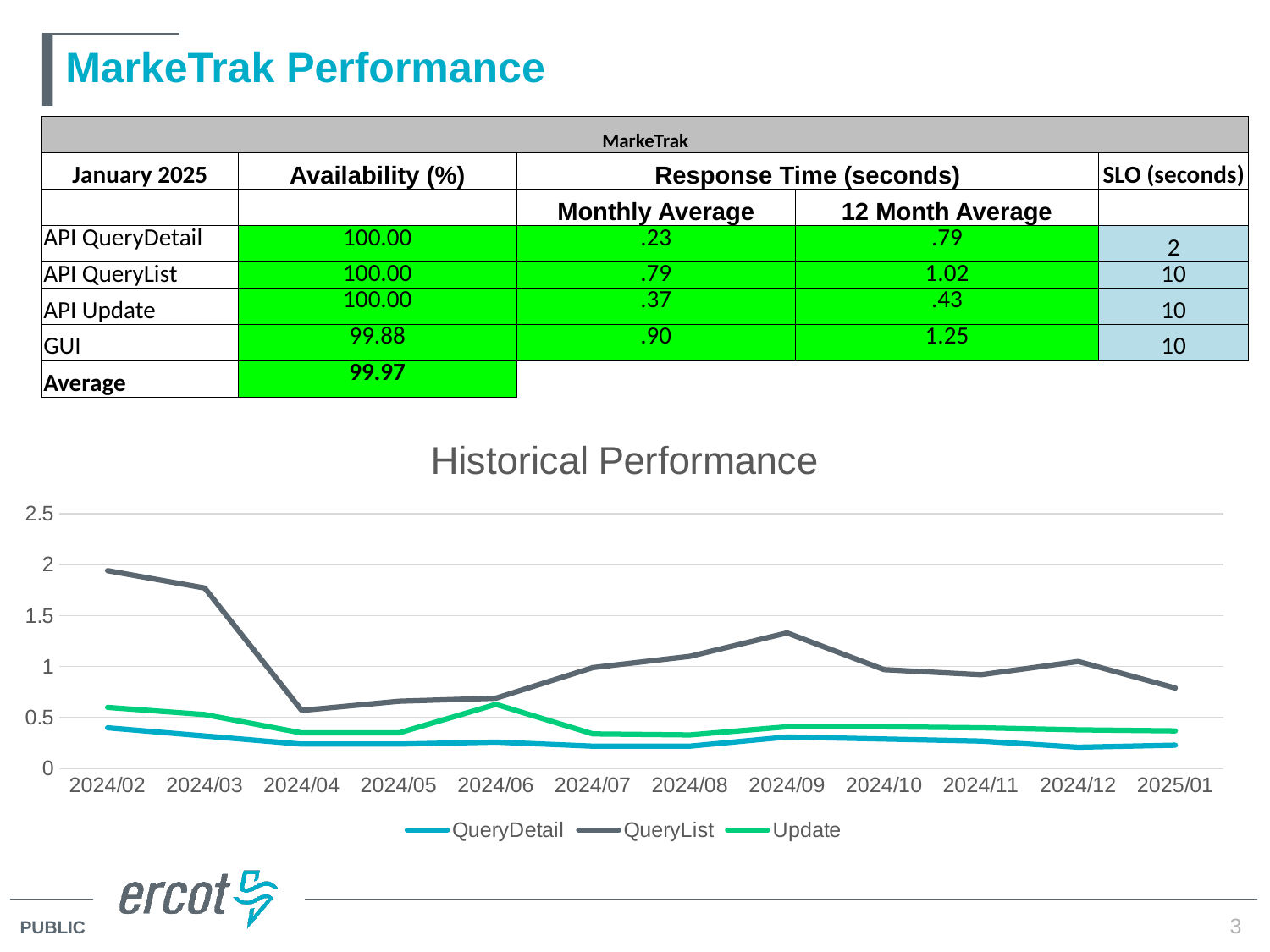
How many series does the legend of the Historical Performance chart list? 3 What kind of chart is the Historical Performance chart? line chart How many months are plotted along the x axis of the Historical Performance chart? 12 In the Historical Performance chart, which month has the highest QueryList value? 2024/02 In the Historical Performance chart, which series has the highest values overall? QueryList In the Historical Performance chart, does the QueryList line rise or fall from 2024/02 to 2024/04? fall In the Historical Performance chart, is the Update value for 2024/06 greater or less than 0.5? greater What is the title of the line chart on the slide? Historical Performance In the Historical Performance chart, is the QueryList value for 2024/04 greater or less than 1? less In the Historical Performance chart, which is larger at 2024/06: the Update value or the QueryDetail value? Update In the Historical Performance chart, is the QueryList value for 2024/02 greater or less than 1.5? greater In the Historical Performance chart, which series has the lowest values overall? QueryDetail